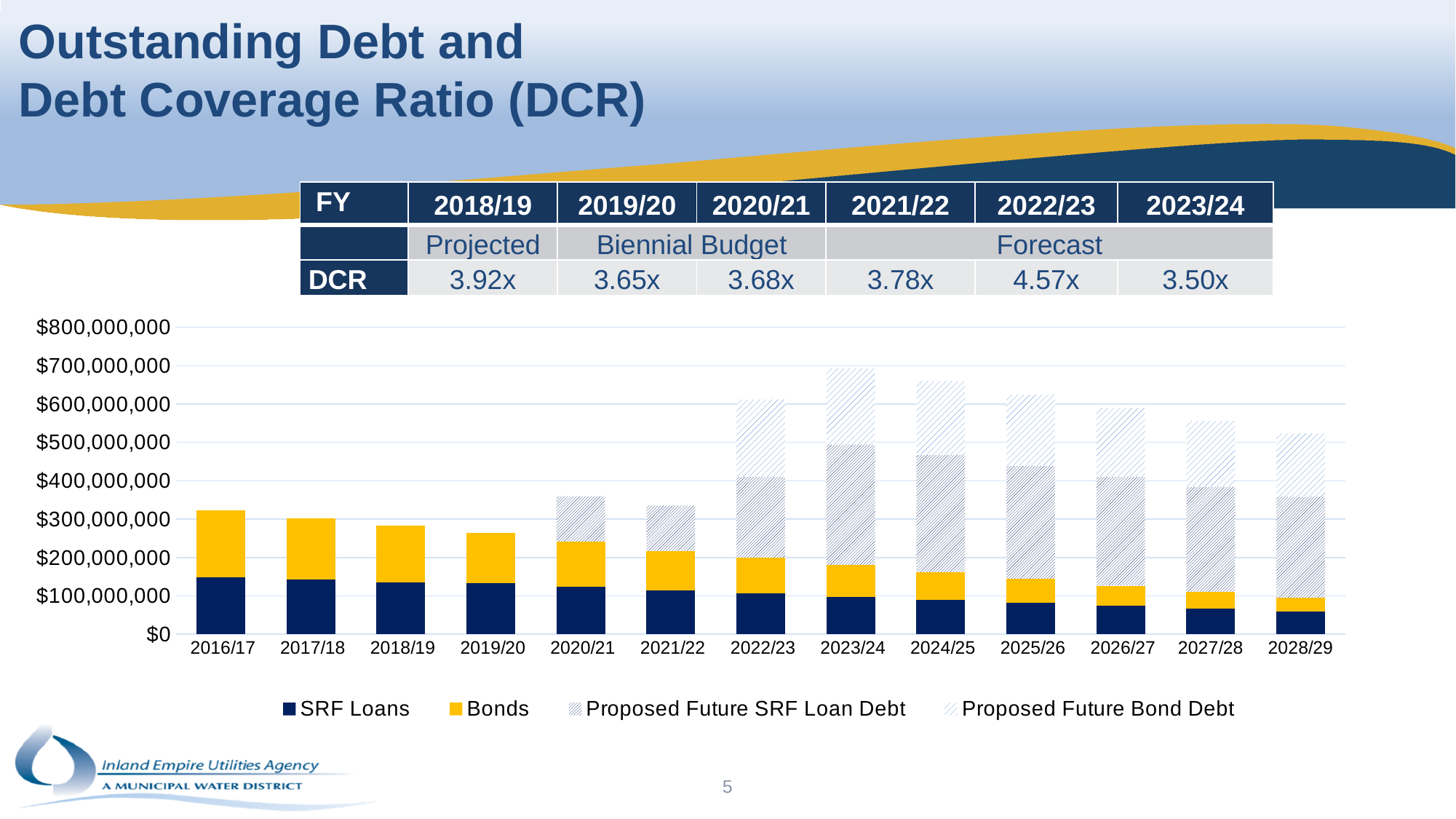
Which fiscal year has the larger Bonds segment, 2016/17 or 2028/29? 2016/17 Is the total bar for 2023/24 greater or less than $600,000,000? greater Is the total bar for 2019/20 greater or less than $300,000,000? less Is the total bar for 2016/17 greater or less than $300,000,000? greater How many fiscal years are shown along the x axis of the chart? 13 What kind of chart is shown on the slide? bar chart How many series does the chart's legend list? 4 Which fiscal year has the tallest total stacked bar? 2023/24 Does the SRF Loans series rise or fall from 2016/17 to 2028/29? fall Which fiscal year has the larger total bar, 2021/22 or 2022/23? 2022/23 Which series is shown in yellow in the chart? Bonds